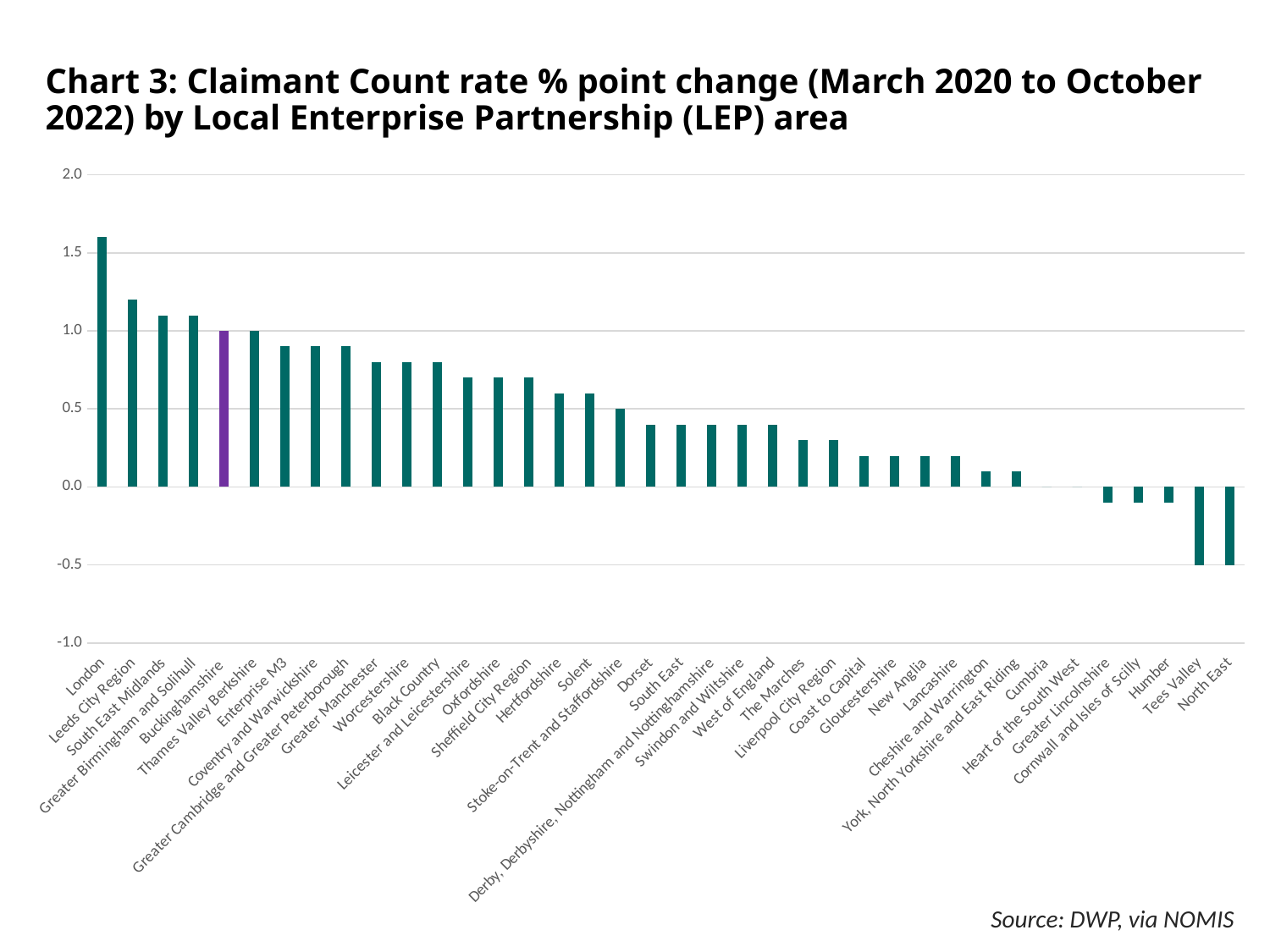
Which LEP area is highlighted with a purple bar? Buckinghamshire What kind of chart is shown on the slide? bar chart Is the value for Dorset greater or less than 0.5? less What is the Claimant Count rate % point change for Buckinghamshire? 1.0 What is the Claimant Count rate % point change for Tees Valley? -0.5 Is the value for Leeds City Region greater or less than 1.0? greater Is the value for Greater Manchester greater or less than 0.5? greater Which has the larger value, London or Leeds City Region? London Which LEP area has the highest Claimant Count rate % point change? London Do the values rise or fall moving from left to right along the x axis? fall